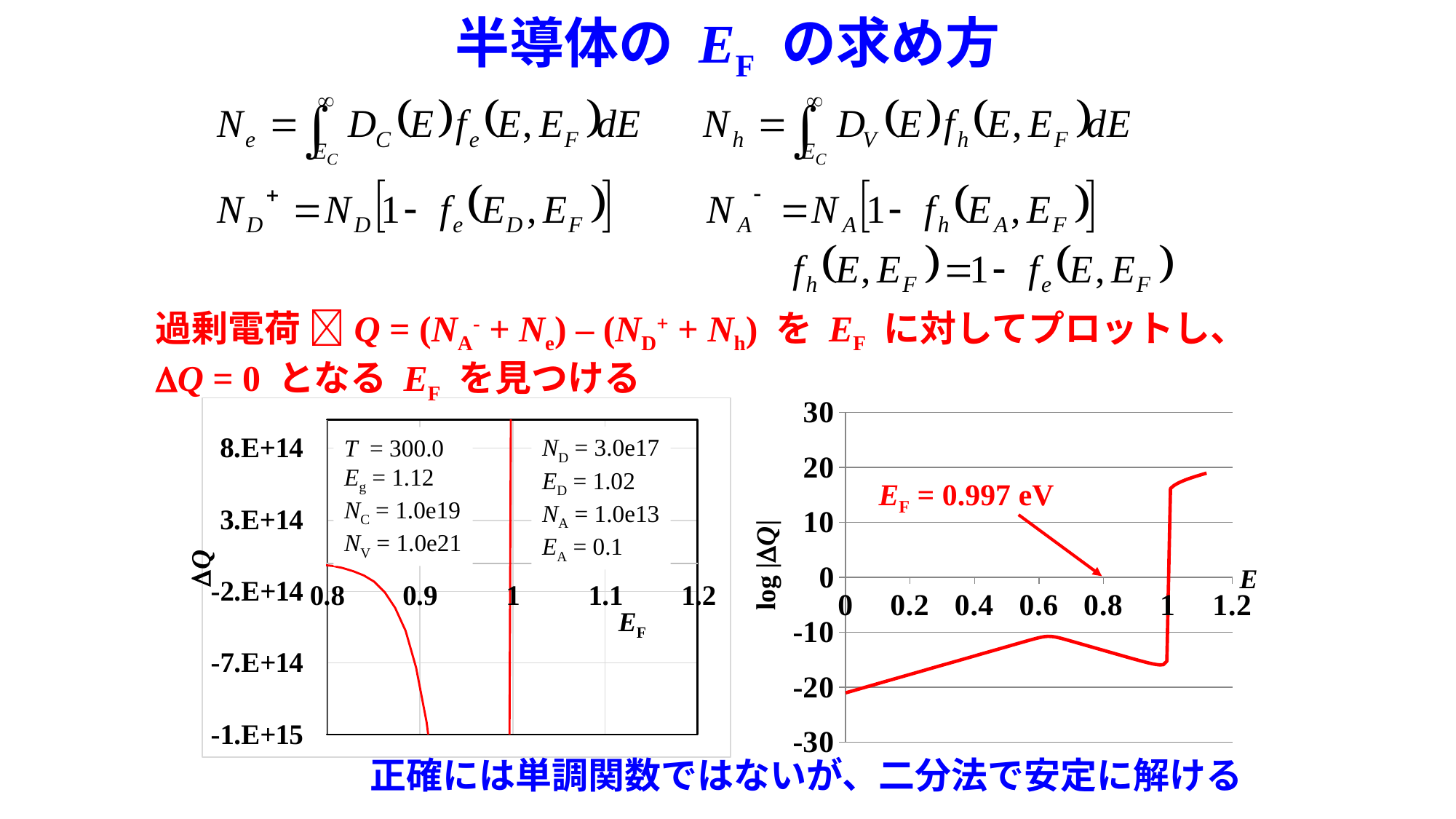
In the left chart, what value of N_D is listed in the parameter box? 3.0e17 In the left chart, what is the label of the horizontal axis? E_F In the left chart, does ΔQ rise or fall as E_F increases from 0.8 to 0.95? fall What kind of chart is the left chart (ΔQ versus E_F)? line chart In the left chart, what temperature T is listed in the parameter box? 300.0 In the right chart, which is larger: log|ΔQ| at E = 0.2 or at E = 1.1? E = 1.1 In the right chart, does log|ΔQ| rise or fall as E increases from 0 to 0.6? rise What kind of chart is the right chart (log|ΔQ| versus E)? line chart In the right chart, is the value of log|ΔQ| at E = 1.1 greater or less than 10? greater In the right chart, what is the label of the vertical axis? log|ΔQ| In the right chart, what value of E_F is indicated by the annotation? 0.997 eV In the left chart, is the value of ΔQ at E_F = 0.9 greater or less than 3.E+14? less